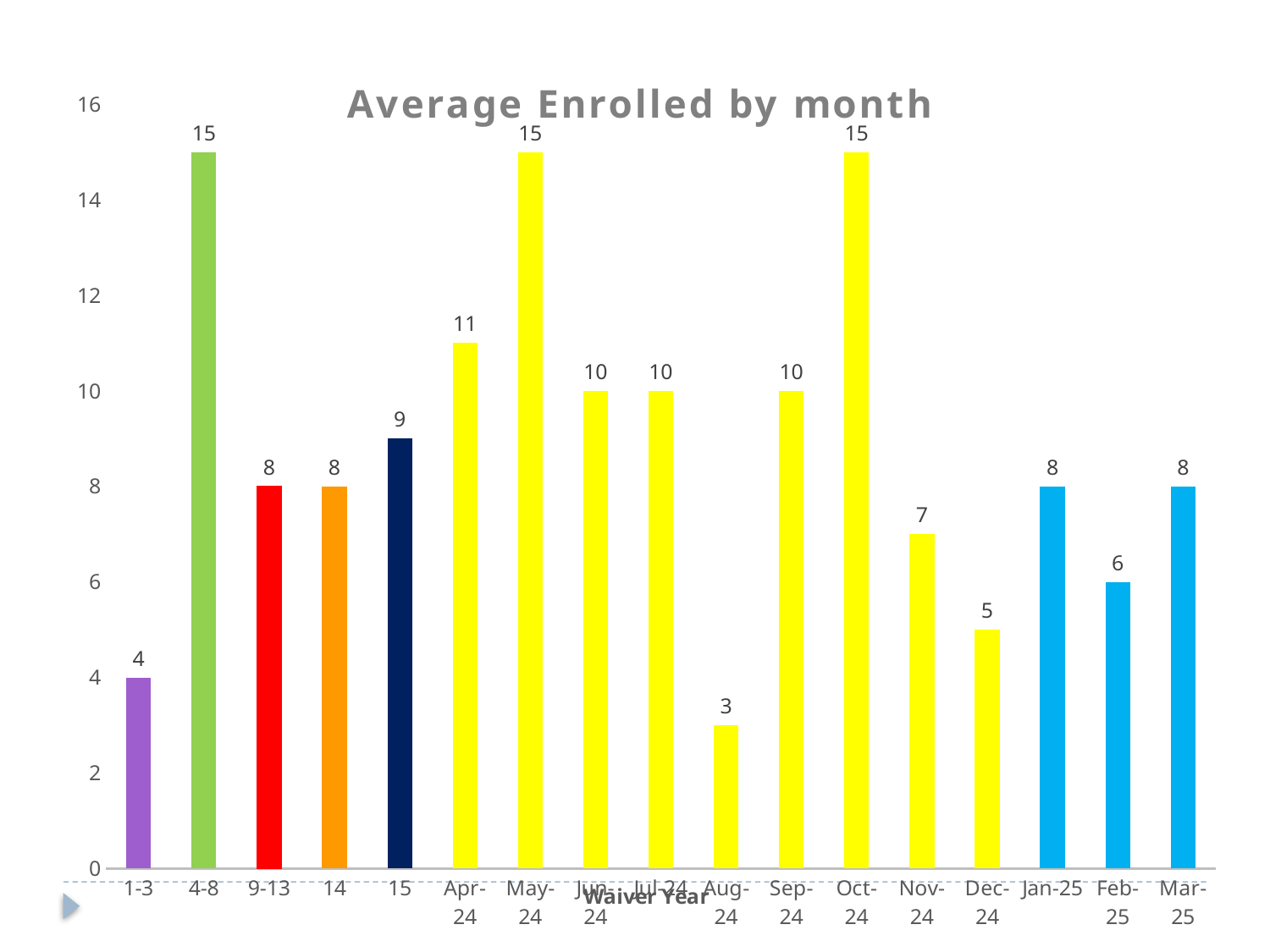
How many categories are shown on the x axis? 17 What is the title of the chart? Average Enrolled by month Is the value for Oct-24 greater or less than 12? greater What is the value for Apr-24? 11 What is the value for Dec-24? 5 Which is larger, the value for 15 or the value for Jan-25? 15 What kind of chart is this? bar chart What is the difference between the values for Apr-24 and Feb-25? 5 What is the value for Aug-24? 3 What is the difference between the values for May-24 and Nov-24? 8 What is the value for the 1-3 category? 4 Which category has the lowest value? Aug-24